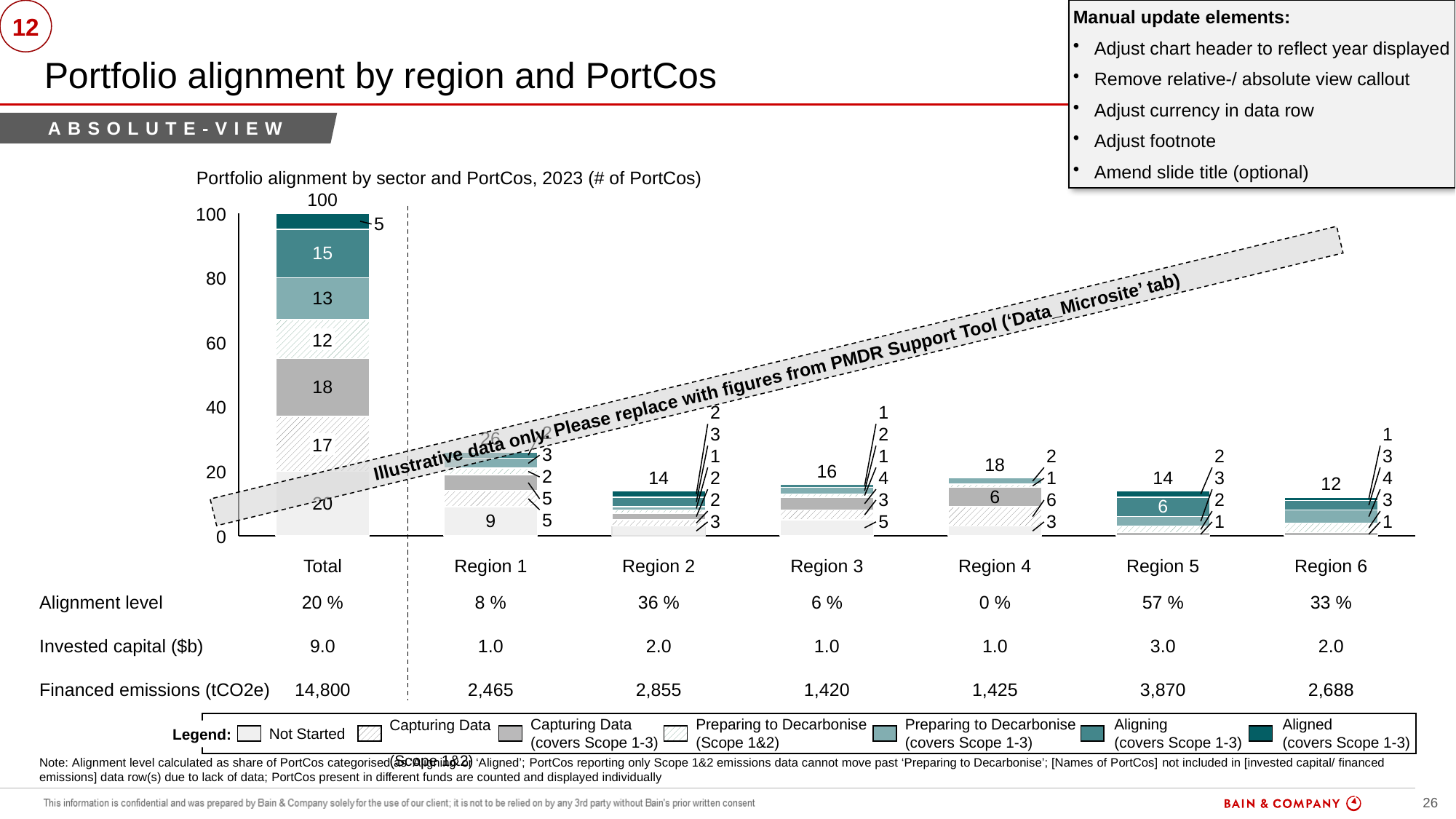
In the Total bar, what is the value of the Aligning (covers Scope 1-3) segment? 15 What is the total number of PortCos shown on top of the Total bar? 100 What is the total value shown above the Region 4 bar? 18 What kind of chart is shown on the slide? Stacked bar chart What is the total value shown above the Region 6 bar? 12 What is the difference between the total for Region 4 and the total for Region 6? 6 Which region has the lowest total number of PortCos? Region 6 How many series does the legend list? 7 Which has a larger total number of PortCos, Region 3 or Region 5? Region 3 In the Total bar, what is the value of the Not Started segment? 20 How many bars (categories) are shown on the x axis? 7 In the Total bar, what is the value of the Aligned (covers Scope 1-3) segment? 5